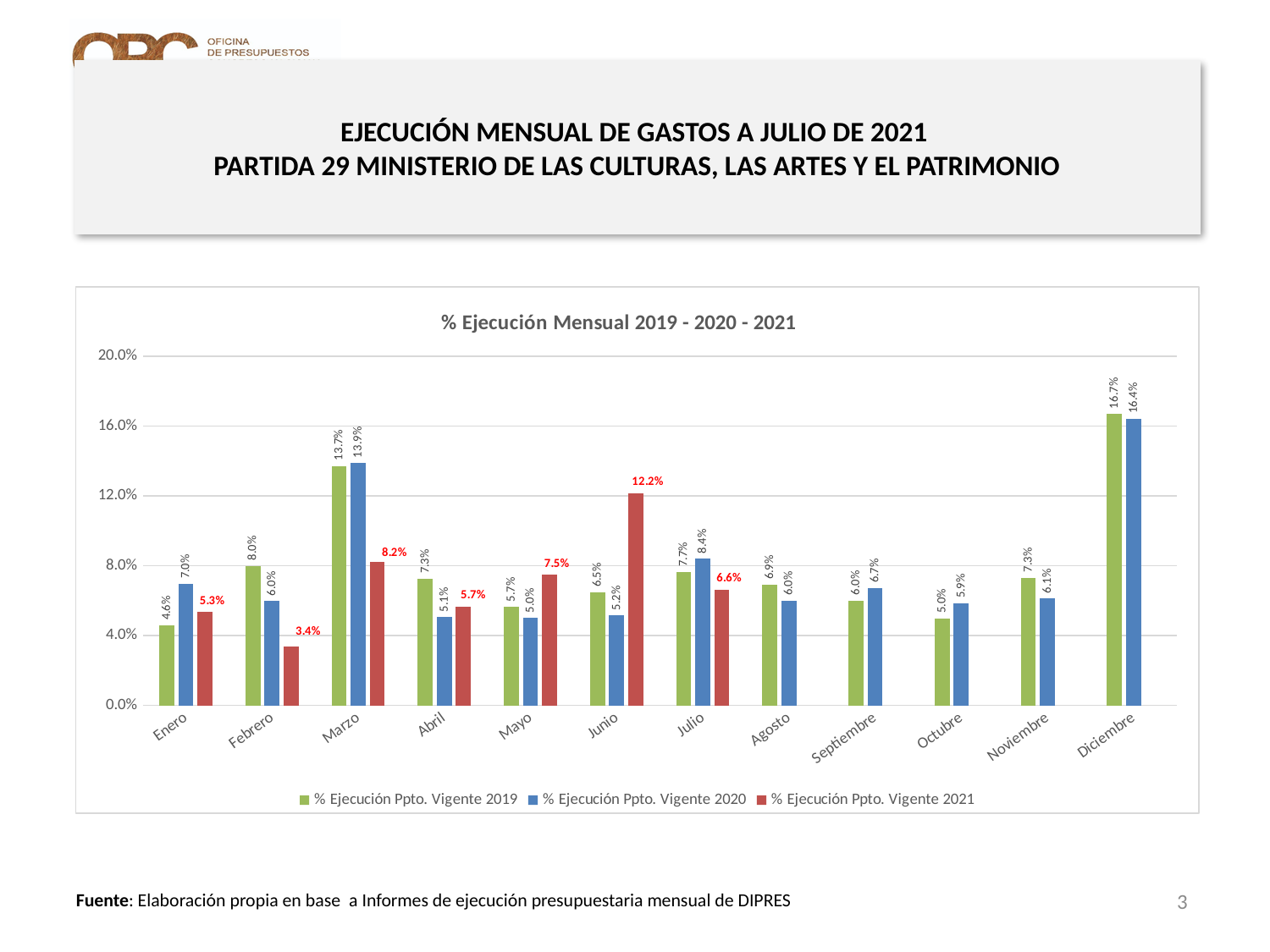
What is the value for % Ejecución Ppto. Vigente 2021 in Junio? 12.2% What is the difference between the 2021 value and the 2019 value in Junio? 5.7% How many months are shown on the x axis? 12 How many series does the legend list? 3 What is the value for % Ejecución Ppto. Vigente 2019 in Diciembre? 16.7% In Enero, which is larger: the 2020 value or the 2019 value? 2020 (7.0%) Is the value for % Ejecución Ppto. Vigente 2021 in Marzo greater or less than 8.0%? greater What is the title of the chart? % Ejecución Mensual 2019 - 2020 - 2021 What kind of chart is shown on the slide? Bar chart What is the value for % Ejecución Ppto. Vigente 2020 in Marzo? 13.9% Which month has the lowest value for % Ejecución Ppto. Vigente 2021? Febrero Which month has the highest value for % Ejecución Ppto. Vigente 2020? Diciembre